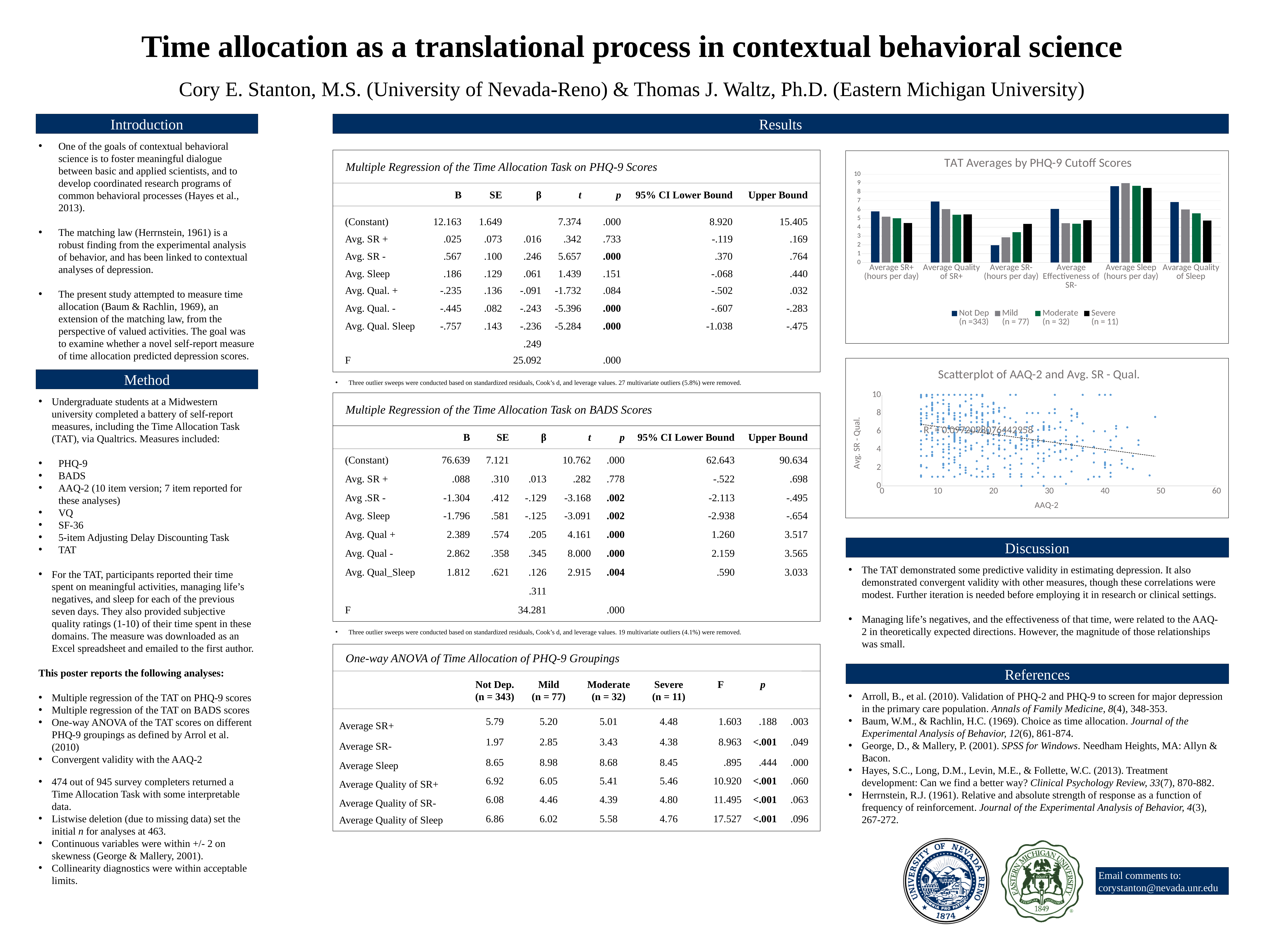
In the 'TAT Averages by PHQ-9 Cutoff Scores' chart, which category has the tallest bars overall? Average Sleep (hours per day) What kind of chart is 'Scatterplot of AAQ-2 and Avg. SR - Qual.'? scatter plot In the 'TAT Averages by PHQ-9 Cutoff Scores' chart, is the Not Dep value for Average Sleep (hours per day) greater or less than 8? greater In the 'TAT Averages by PHQ-9 Cutoff Scores' chart, how many series does the legend list? 4 In the 'TAT Averages by PHQ-9 Cutoff Scores' chart, which category has the lowest bar overall? Average SR- (hours per day) In the 'TAT Averages by PHQ-9 Cutoff Scores' chart, is the Not Dep value for Average Quality of SR+ greater or less than 6? greater What kind of chart is 'TAT Averages by PHQ-9 Cutoff Scores'? bar chart In the 'TAT Averages by PHQ-9 Cutoff Scores' chart, for Average SR- (hours per day), is the Not Dep bar or the Severe bar taller? Severe In the 'TAT Averages by PHQ-9 Cutoff Scores' chart, is the Not Dep value for Average SR- (hours per day) greater or less than 3? less In the 'TAT Averages by PHQ-9 Cutoff Scores' chart, do the bars for Average Quality of Sleep rise or fall from Not Dep to Severe? fall In the 'TAT Averages by PHQ-9 Cutoff Scores' chart, how many categories are shown on the x axis? 6 In the 'Scatterplot of AAQ-2 and Avg. SR - Qual.' chart, what is the label of the x axis? AAQ-2